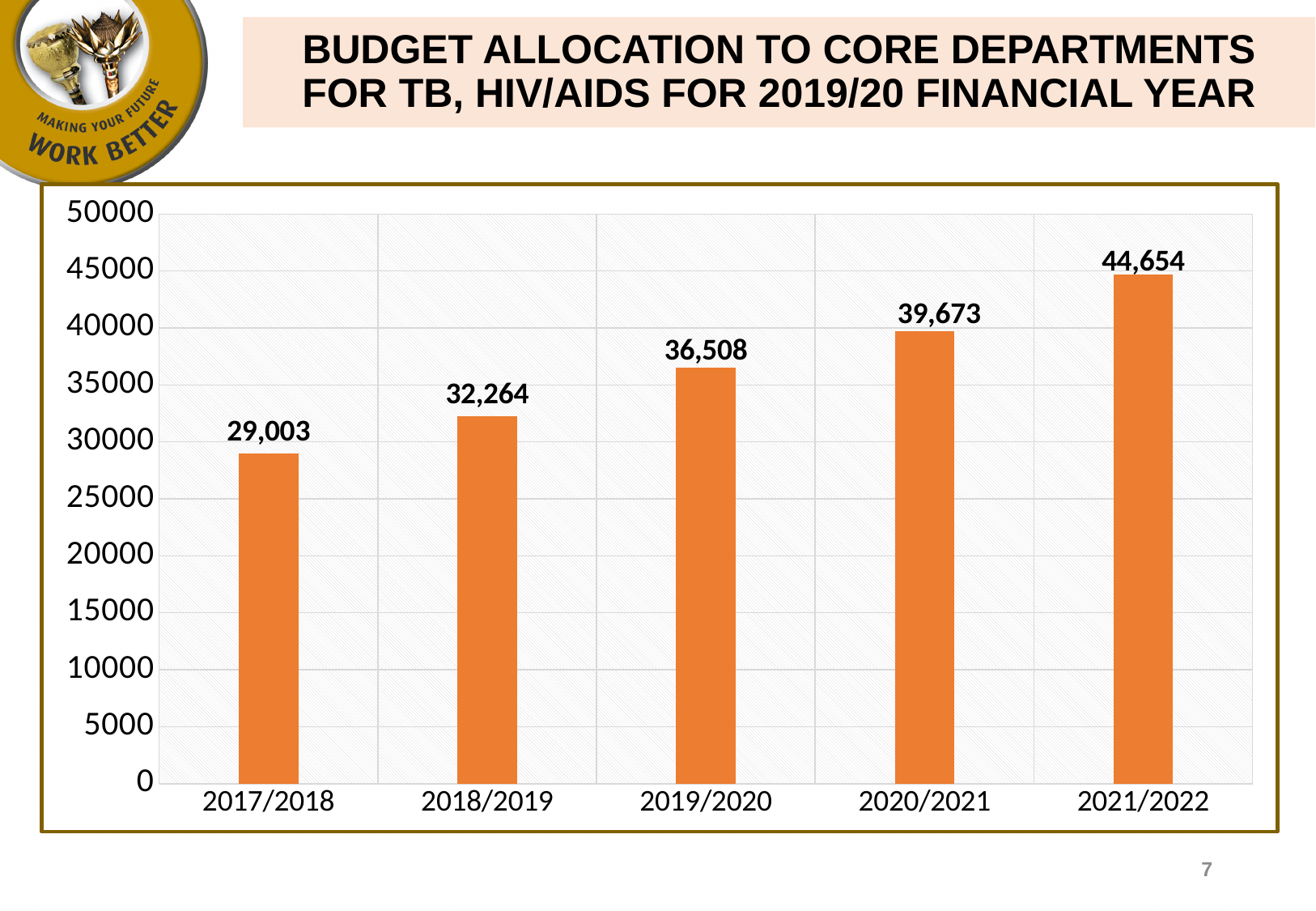
Which year has the highest value? 2021/2022 Do the values rise or fall from 2017/2018 to 2021/2022? rise What kind of chart is shown on the slide? bar chart Which year has the lowest value? 2017/2018 What is the value for 2017/2018? 29,003 What is the difference between the values for 2021/2022 and 2020/2021? 4,981 What is the difference between the values for 2018/2019 and 2017/2018? 3,261 Which is larger, the value for 2019/2020 or the value for 2018/2019? 2019/2020 How many years are shown on the x axis? 5 What is the value for 2021/2022? 44,654 What is the value for 2019/2020? 36,508 Is the value for 2020/2021 greater or less than 35000? greater